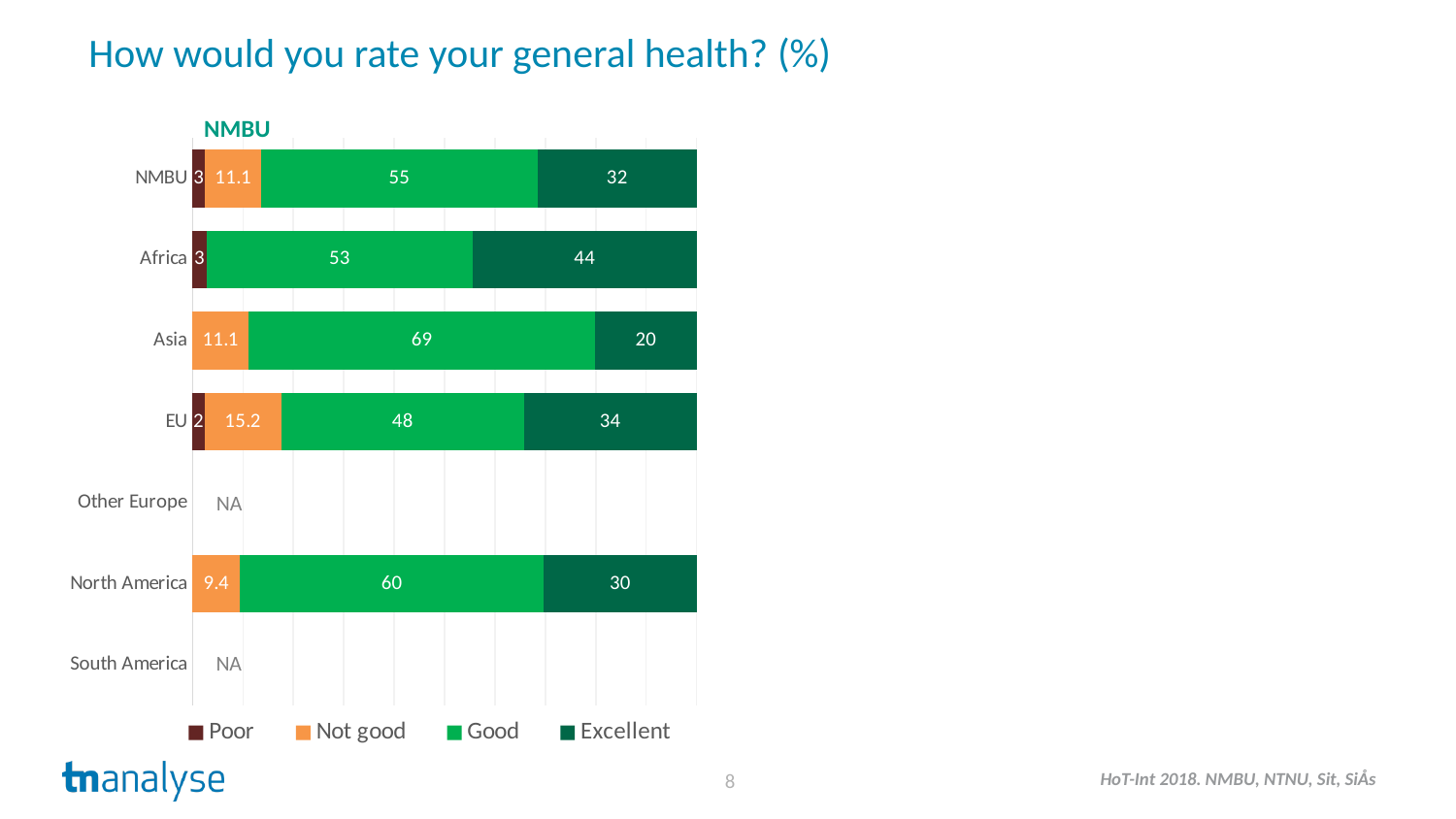
Which categories are shown as NA? Other Europe and South America What kind of chart is shown on the slide? Stacked bar chart What is the Not good value for North America? 9.4 Which category has the lowest Excellent value? Asia What is the difference between the Excellent values for Africa and NMBU? 12 What is the Good value for Asia? 69 Which category has the highest Good value? Asia Which is larger, the Good value for North America or the Good value for EU? North America What is the total of the stacked bar for EU? 99.2 What is the Excellent value for Africa? 44 What is the Not good value for EU? 15.2 How many series does the legend list? 4